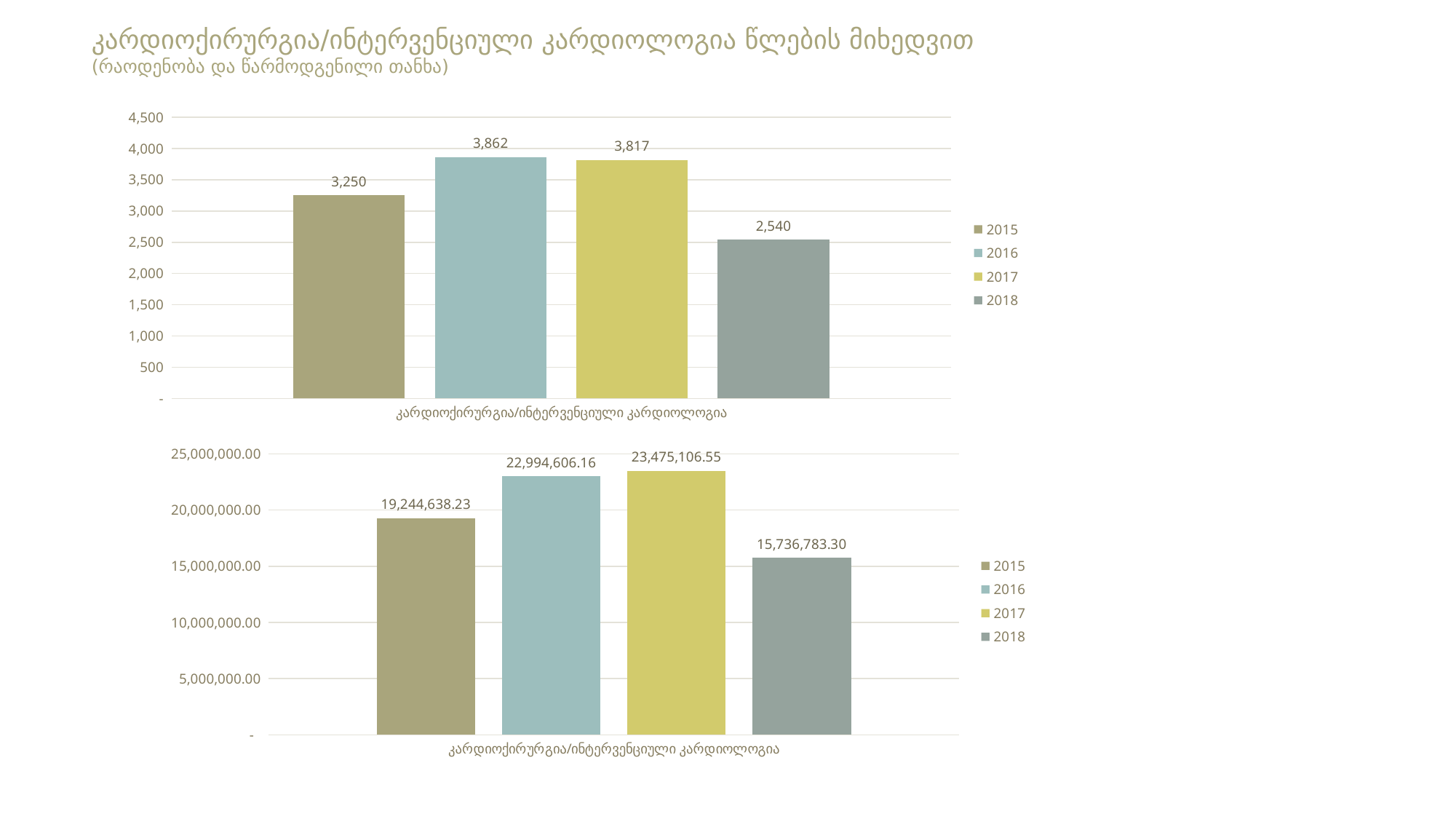
In the top chart, what is the value for 2018? 2,540 In the top chart, which year has the highest value? 2016 What kind of chart is the bottom chart? bar chart In the bottom chart, is the value for 2015 greater or less than 20,000,000.00? less In the bottom chart, which is larger, the value for 2016 or the value for 2015? 2016 In the top chart, how many series does the legend list? 4 In the bottom chart, what is the value for 2018? 15,736,783.30 In the top chart, what is the difference between the 2016 and 2015 values? 612 In the bottom chart, what is the value for 2017? 23,475,106.55 In the top chart, which year has the lowest value? 2018 In the top chart, what is the value for 2015? 3,250 In the bottom chart, which year has the lowest value? 2018